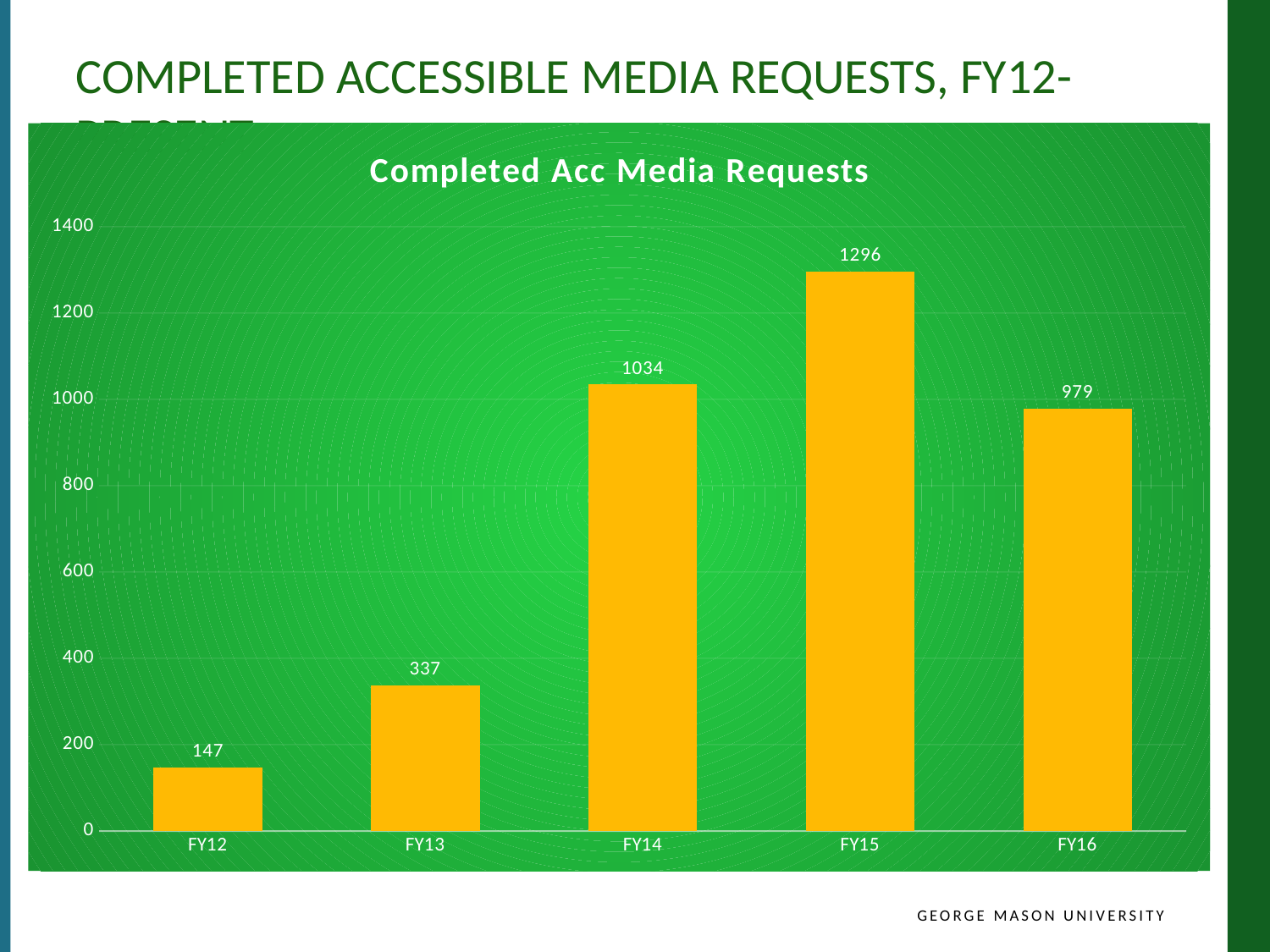
What is the value for FY16? 979 How many fiscal years are shown on the x axis? 5 What is the difference between the values for FY15 and FY14? 262 What is the title of the chart? Completed Acc Media Requests Which is larger, the value for FY14 or the value for FY16? FY14 What is the difference between the values for FY13 and FY12? 190 Which fiscal year has the lowest number of completed requests? FY12 What is the value for FY12? 147 Which fiscal year has the highest number of completed requests? FY15 What kind of chart is shown on the slide? bar chart Is the value for FY13 greater or less than 400? less What is the value for FY14? 1034